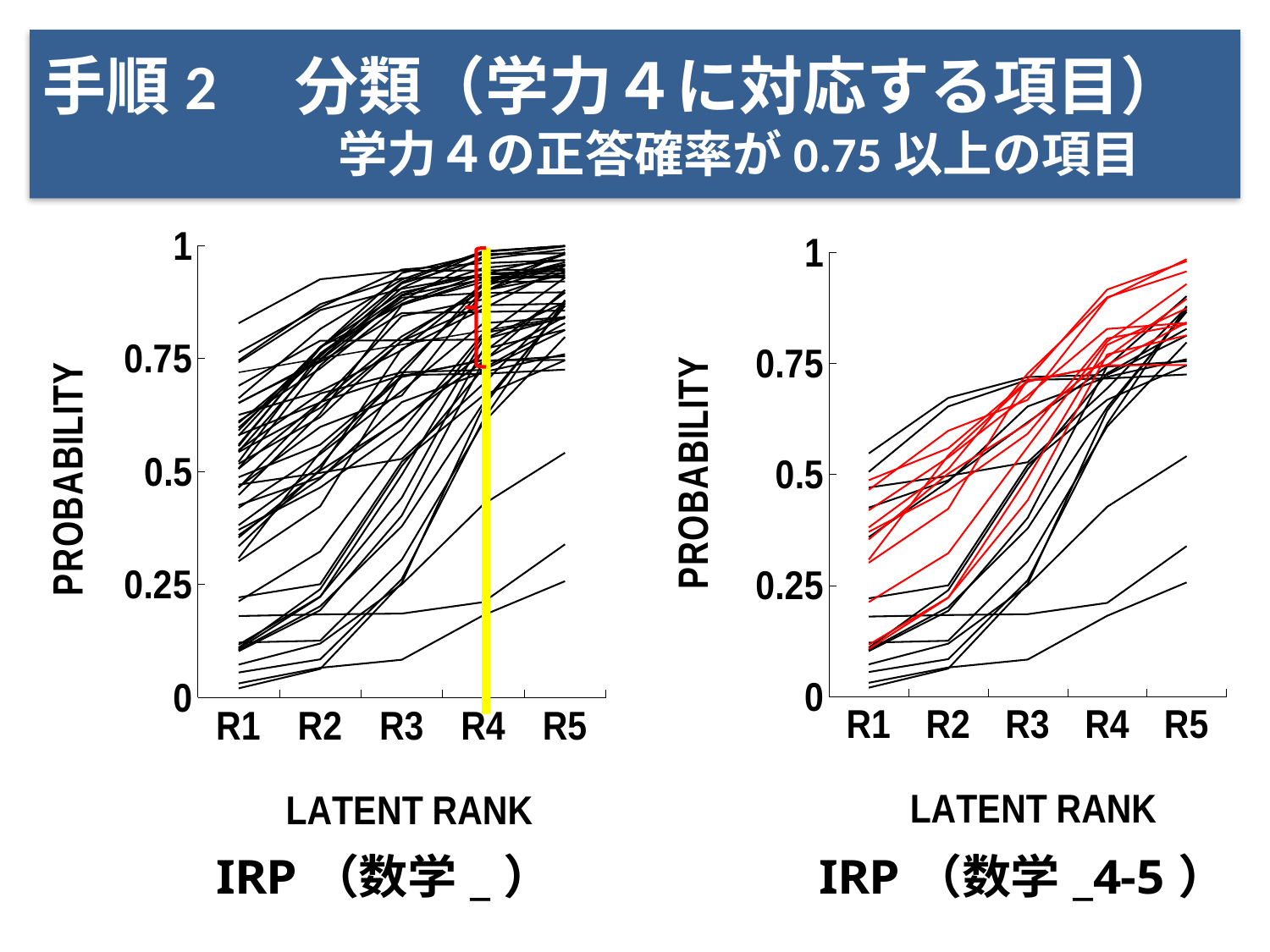
In the right chart titled IRP (数学_4-5), do the red lines generally rise or fall from R1 to R5? rise How many latent rank categories are shown on the x axis of the right chart titled IRP (数学_4-5)? 5 What kind of chart is the left chart titled IRP (数学_)? line chart In the right chart titled IRP (数学_4-5), is the value of the lowest line at R1 greater or less than 0.25? less In the right chart titled IRP (数学_4-5), is the value of the highest red line at R5 greater or less than 0.75? greater In the left chart titled IRP (数学_), do the lines generally rise or fall from R1 to R5? rise In the left chart titled IRP (数学_), is the value of the highest line at R5 greater or less than 0.75? greater What is the first category on the x axis of the left chart titled IRP (数学_)? R1 What is the label of the y axis on the left chart titled IRP (数学_)? PROBABILITY What is the label of the x axis on the right chart titled IRP (数学_4-5)? LATENT RANK What is the highest tick value shown on the y axis of the left chart titled IRP (数学_)? 1